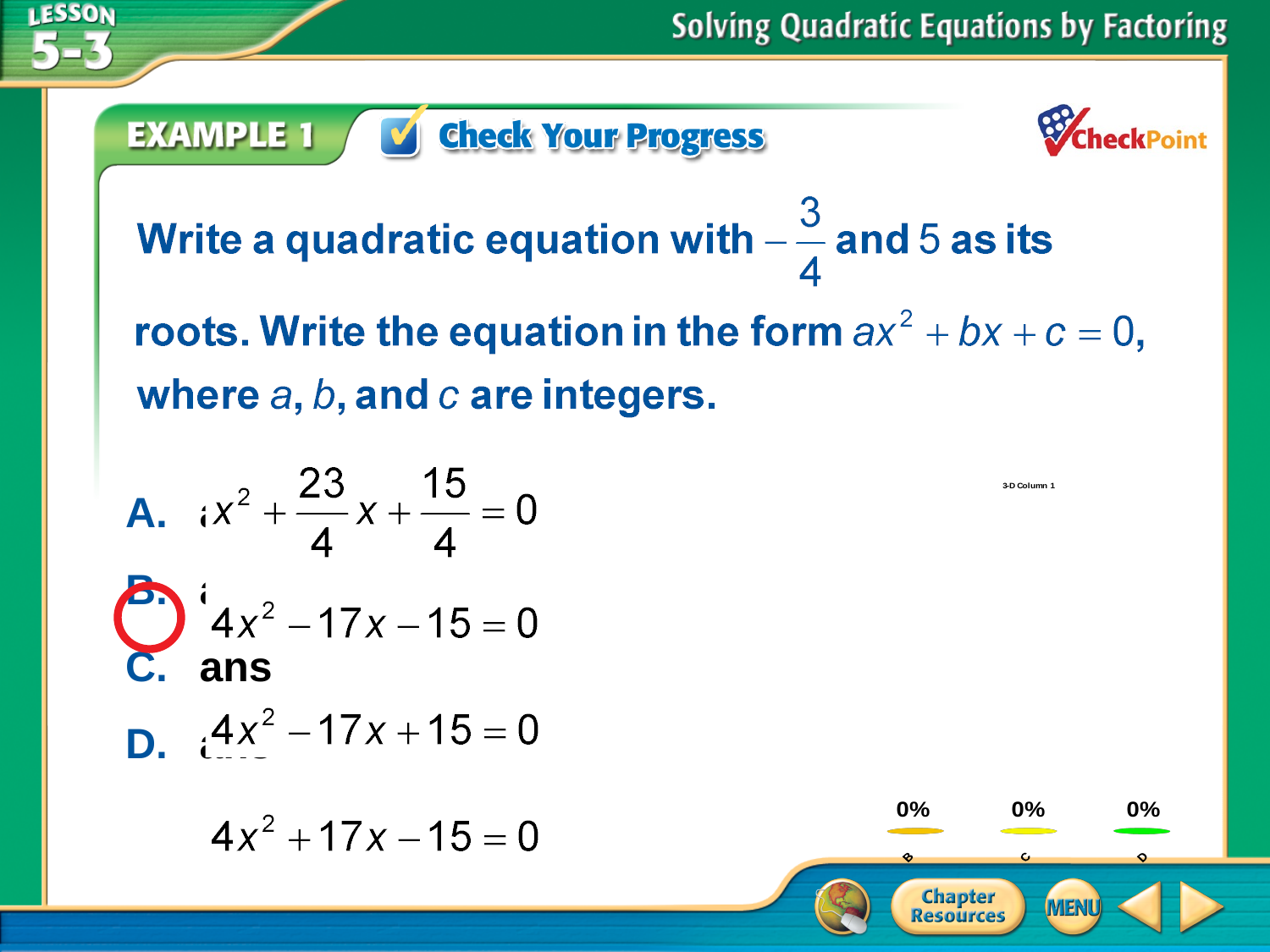
In the chart titled 3-D Column 1, what value is labelled on the bar for category B? 0% What is the title of the chart on the slide? 3-D Column 1 What kind of chart is shown at the bottom right of the slide? bar chart In the chart titled 3-D Column 1, is the value for C larger than the value for D, or are they equal? equal In the chart titled 3-D Column 1, what value is labelled on the bar for category C? 0% In the chart titled 3-D Column 1, what is the difference between the values for B and D? 0% In the chart titled 3-D Column 1, what value is labelled on the bar for category D? 0% In the chart titled 3-D Column 1, what colour is the bar for category D? green